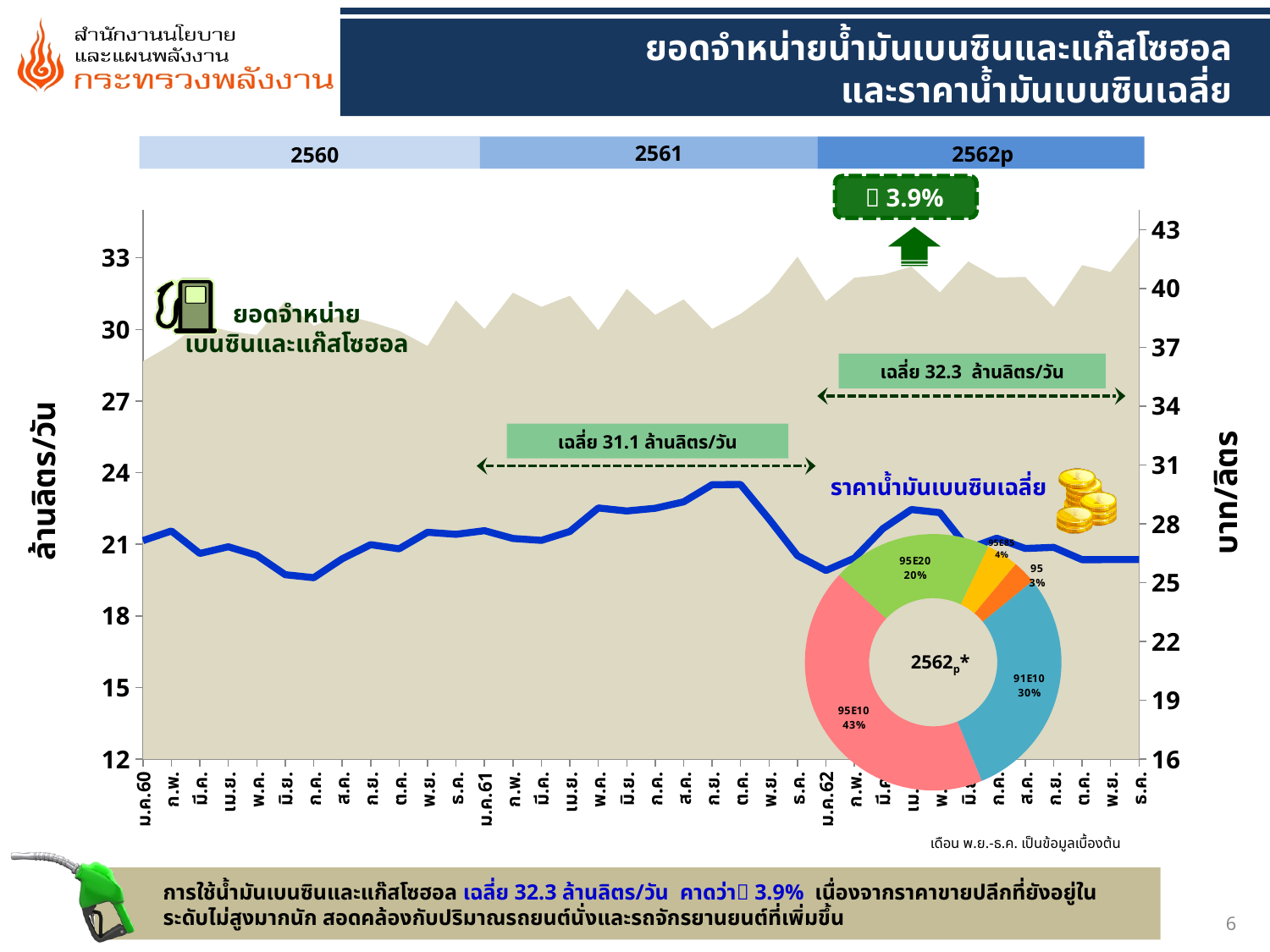
In the main chart, what is the average sales volume shown for 2561? 31.1 ล้านลิตร/วัน In the main chart, what is the average sales volume shown for 2562p? 32.3 ล้านลิตร/วัน In the donut chart labelled 2562p*, which fuel type has the smallest share? 95 In the donut chart labelled 2562p*, what share does 95E10 have? 43% In the donut chart labelled 2562p*, how many fuel types are shown? 5 In the donut chart labelled 2562p*, which has the larger share, 95E20 or 95E85? 95E20 What unit is shown on the right-hand axis of the main chart? บาท/ลิตร In the main chart, is the average gasoline price (blue line) at ม.ค.60 greater or less than 25 บาท/ลิตร? greater In the donut chart labelled 2562p*, what share does 91E10 have? 30% In the main chart, what growth percentage is shown in the green box above 2562p? 3.9% In the donut chart labelled 2562p*, which fuel type has the largest share? 95E10 In the donut chart labelled 2562p*, how many percentage points larger is the 95E10 share than the 91E10 share? 13